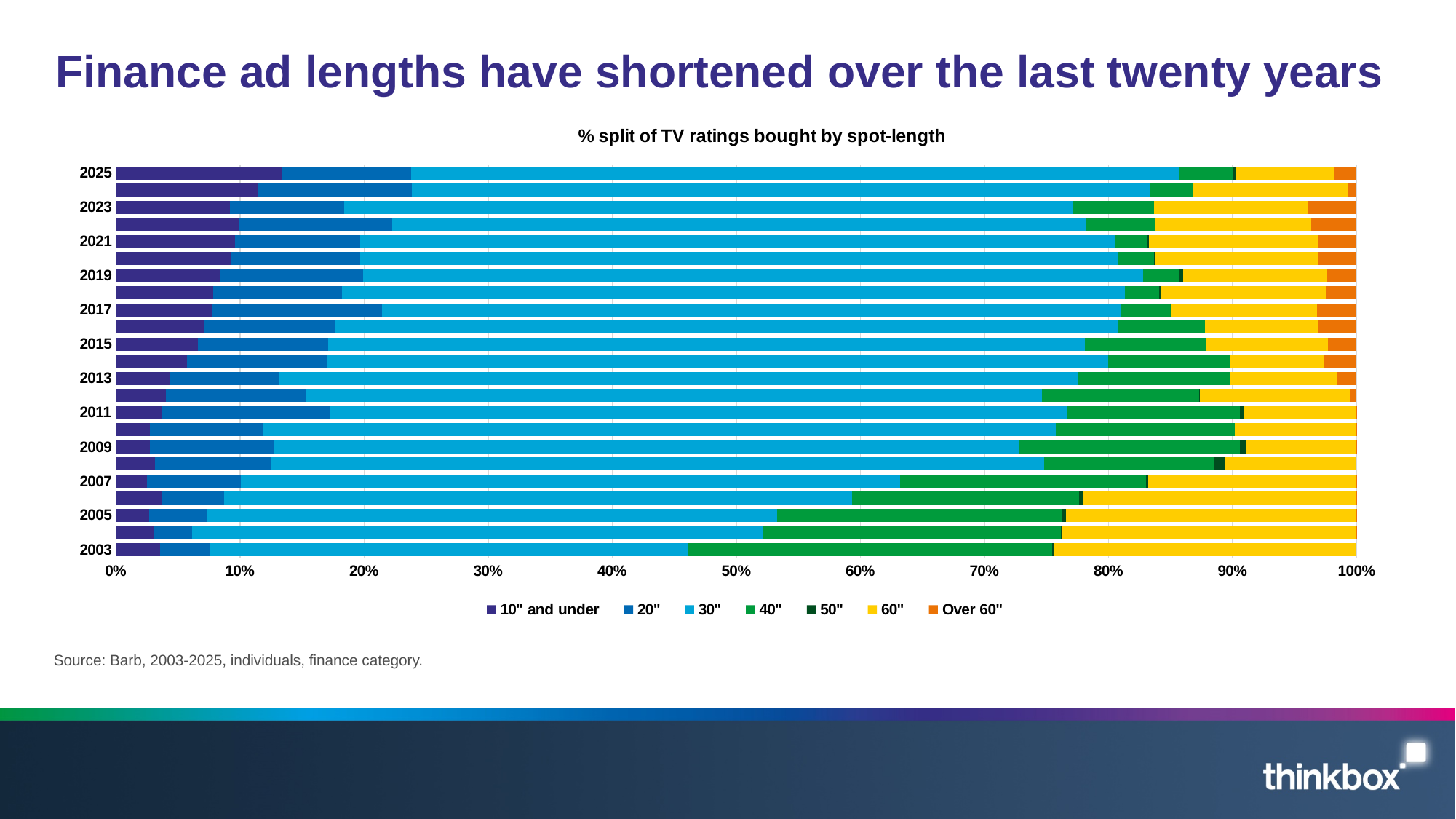
What is the chart's title? % split of TV ratings bought by spot-length Does the share of 40" ads rise or fall from 2003 to 2025? fall How many series does the legend list? 7 In 2003, is the share of 10" and under greater or less than 10%? less In 2025, is the share of 10" and under greater or less than 10%? greater Is the 40" segment larger in 2003 or in 2025? 2003 In 2003, is the combined share of 10" and under, 20" and 30" greater or less than 50%? less How many bars (years) are plotted in the chart? 23 Which year has the largest 40" segment? 2003 What kind of chart is shown on the slide? stacked bar chart What colour represents the 60" series in the legend? yellow Is the 10" and under segment larger in 2025 or in 2003? 2025